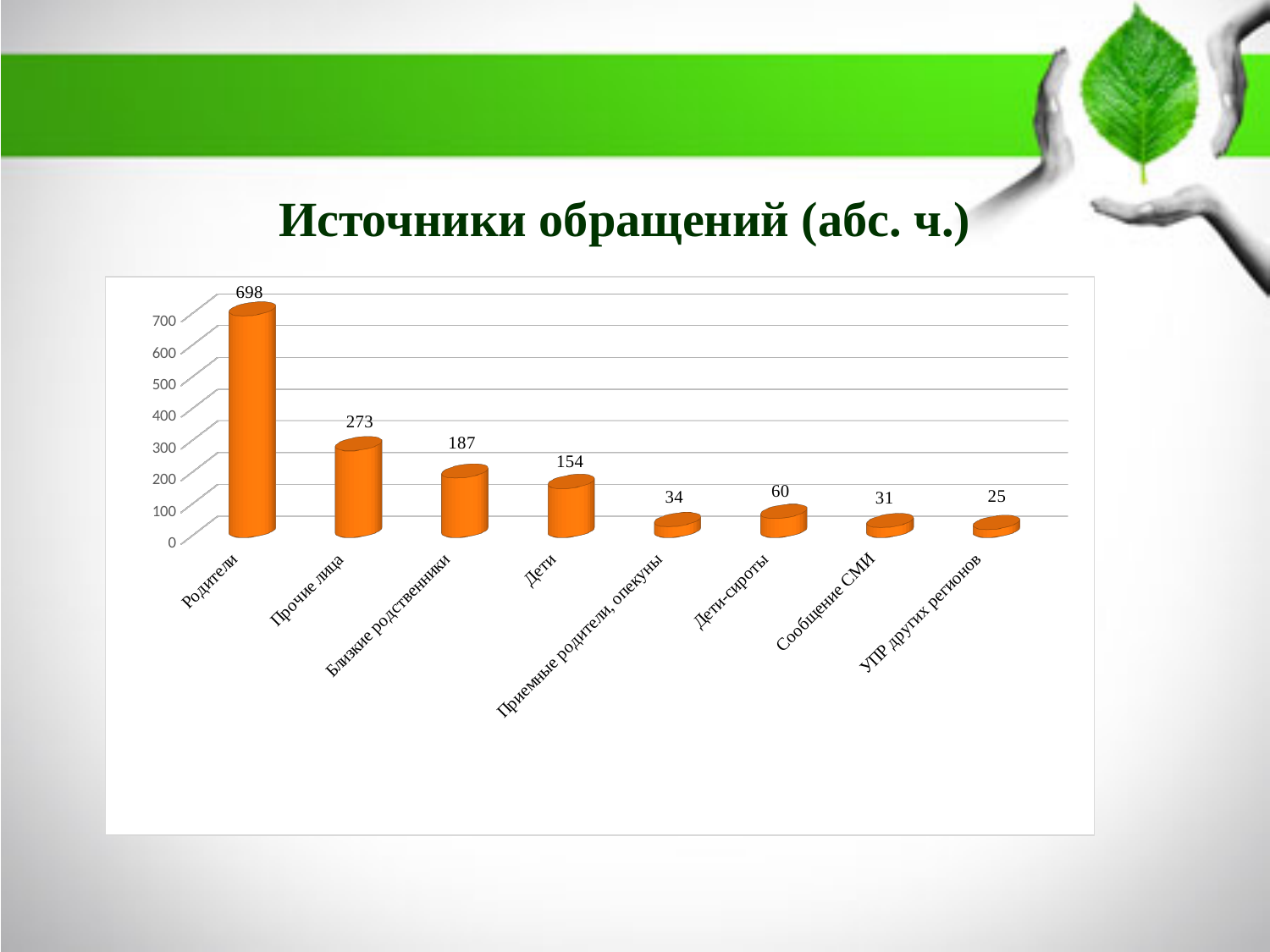
How many categories are shown on the chart? 8 What is the value for Близкие родственники? 187 What is the difference between the values for Родители and Прочие лица? 425 What is the value for Родители? 698 Which category has the lowest value? УПР других регионов What is the value for УПР других регионов? 25 What is the difference between the values for Дети and Дети-сироты? 94 What kind of chart is shown on the slide? bar chart Which category has the highest value? Родители What is the title of the slide? Источники обращений (абс. ч.) Which is larger, the value for Приемные родители, опекуны or the value for Сообщение СМИ? Приемные родители, опекуны What is the value for Дети-сироты? 60